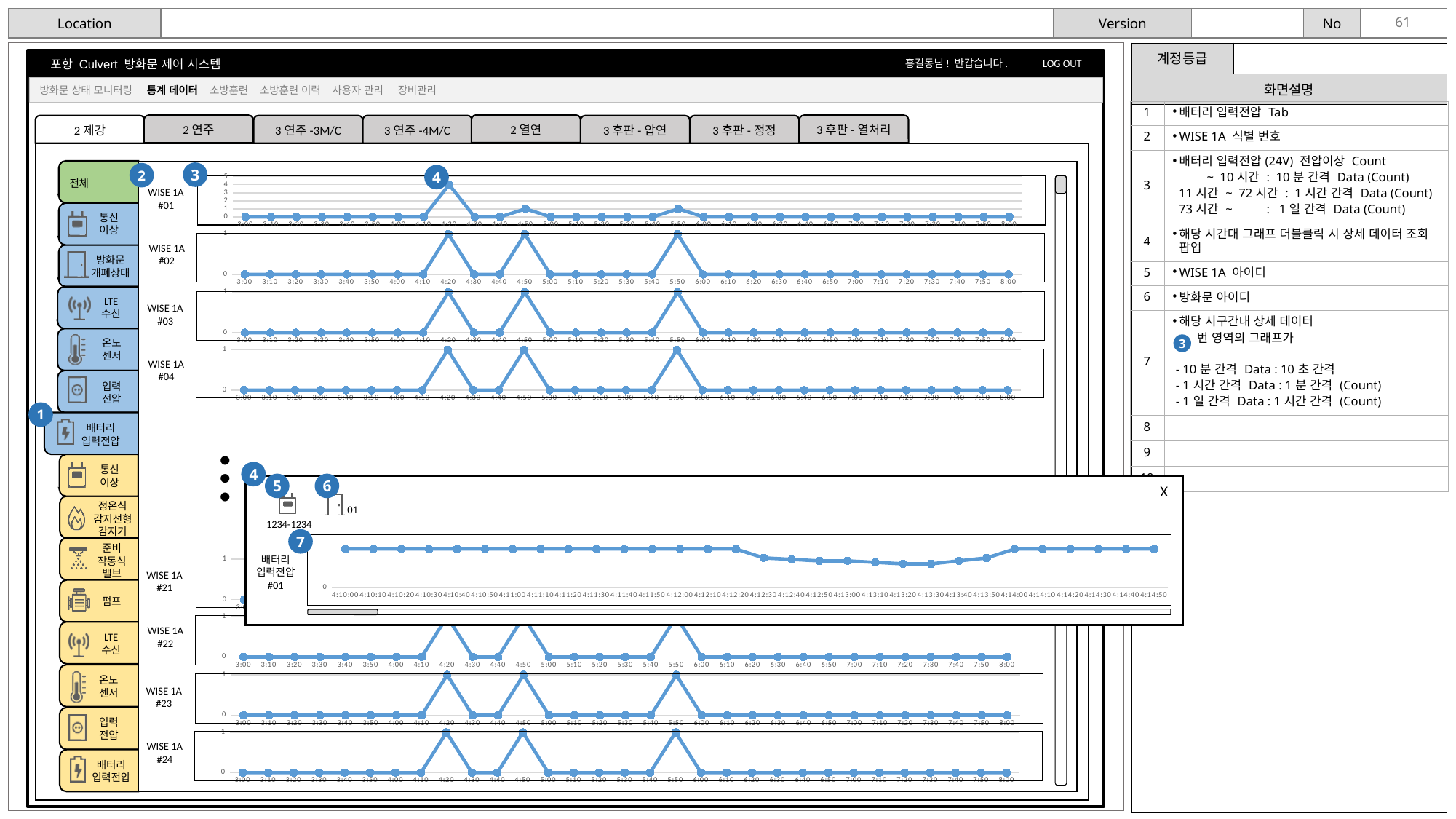
In the WISE 1A #01 chart, is the value at 4:20 greater or less than 3? greater In the WISE 1A #02 chart, what is the value at 3:00? 0 In the popup chart labelled 배터리 입력전압 #01, what is the first time label on the x axis? 4:10:00 In the WISE 1A #02 chart, how many times does the line rise to 1? 3 In the popup chart labelled 배터리 입력전압 #01, what is the last time label on the x axis? 4:14:50 In the popup chart labelled 배터리 입력전압 #01, is the value at 4:13:00 larger or smaller than the value at 4:10:00? smaller In the WISE 1A #02 chart, what is the last time label on the x axis? 8:00 In the WISE 1A #01 chart, what is the highest value shown on the y axis? 5 In the WISE 1A #03 chart, what is the value at 5:00? 0 In the WISE 1A #02 chart, what is the value at 4:20? 1 What kind of chart is used for WISE 1A #02? line chart In the WISE 1A #02 chart, what is the first time label on the x axis? 3:00